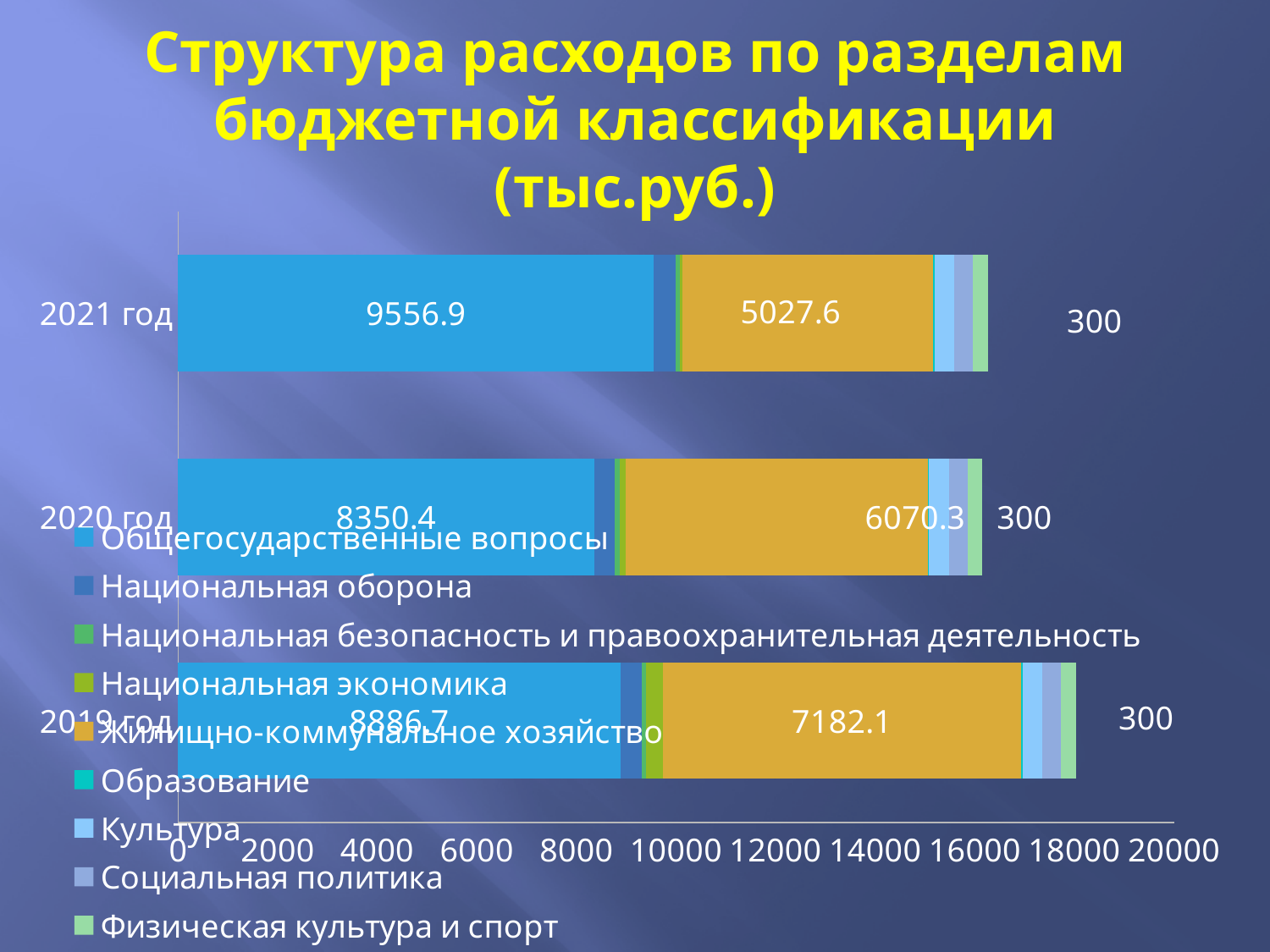
What is the difference between the Жилищно-коммунальное хозяйство values for 2019 год and 2021 год? 2154.5 What type of chart is shown on the slide? Bar chart What is the value for Жилищно-коммунальное хозяйство in 2019 год? 7182.1 In 2021 год, which is larger: Общегосударственные вопросы or Жилищно-коммунальное хозяйство? Общегосударственные вопросы What is the value for Общегосударственные вопросы in 2020 год? 8350.4 How many series does the legend list? 9 In which year is the value for Жилищно-коммунальное хозяйство the lowest? 2021 год What is the value for Общегосударственные вопросы in 2021 год? 9556.9 How many years (categories) are plotted on the chart? 3 Is the total length of the 2019 год bar greater or less than 16000? greater In which year is the value for Общегосударственные вопросы the highest? 2021 год What is the value for Жилищно-коммунальное хозяйство in 2020 год? 6070.3